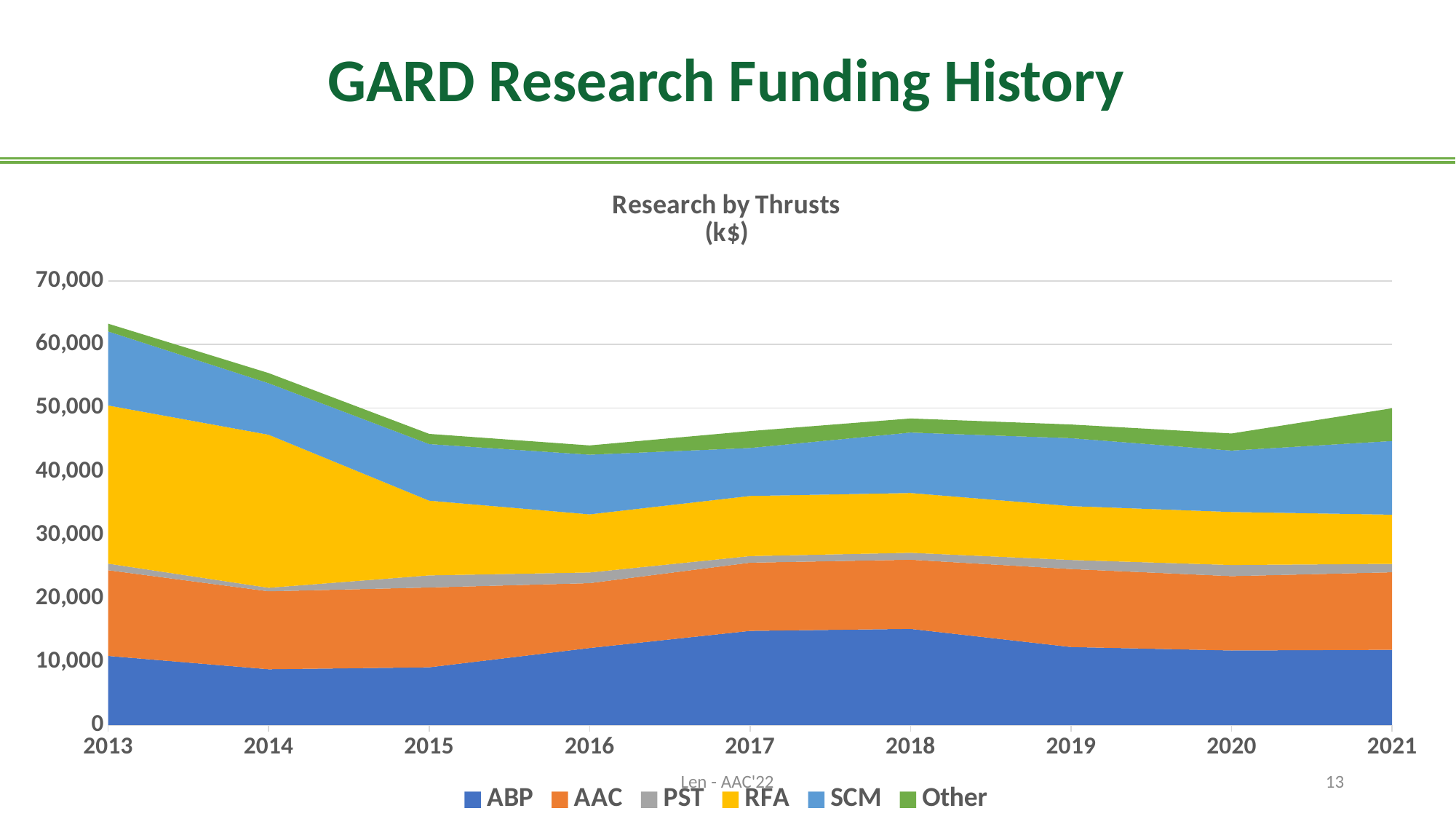
Is the ABP value in 2014 greater or less than 10,000? less Which year has the larger total funding, 2013 or 2021? 2013 How many years are shown along the x axis? 9 Is the total funding in 2016 greater or less than 50,000? less How many series does the legend list? 6 In which year is the total research funding highest? 2013 What is the title of the chart? Research by Thrusts (k$) Is the ABP value in 2017 greater or less than 10,000? greater Which series is shown in yellow? RFA Does the total funding rise or fall from 2013 to 2015? Fall What kind of chart is shown on the slide? Stacked area chart